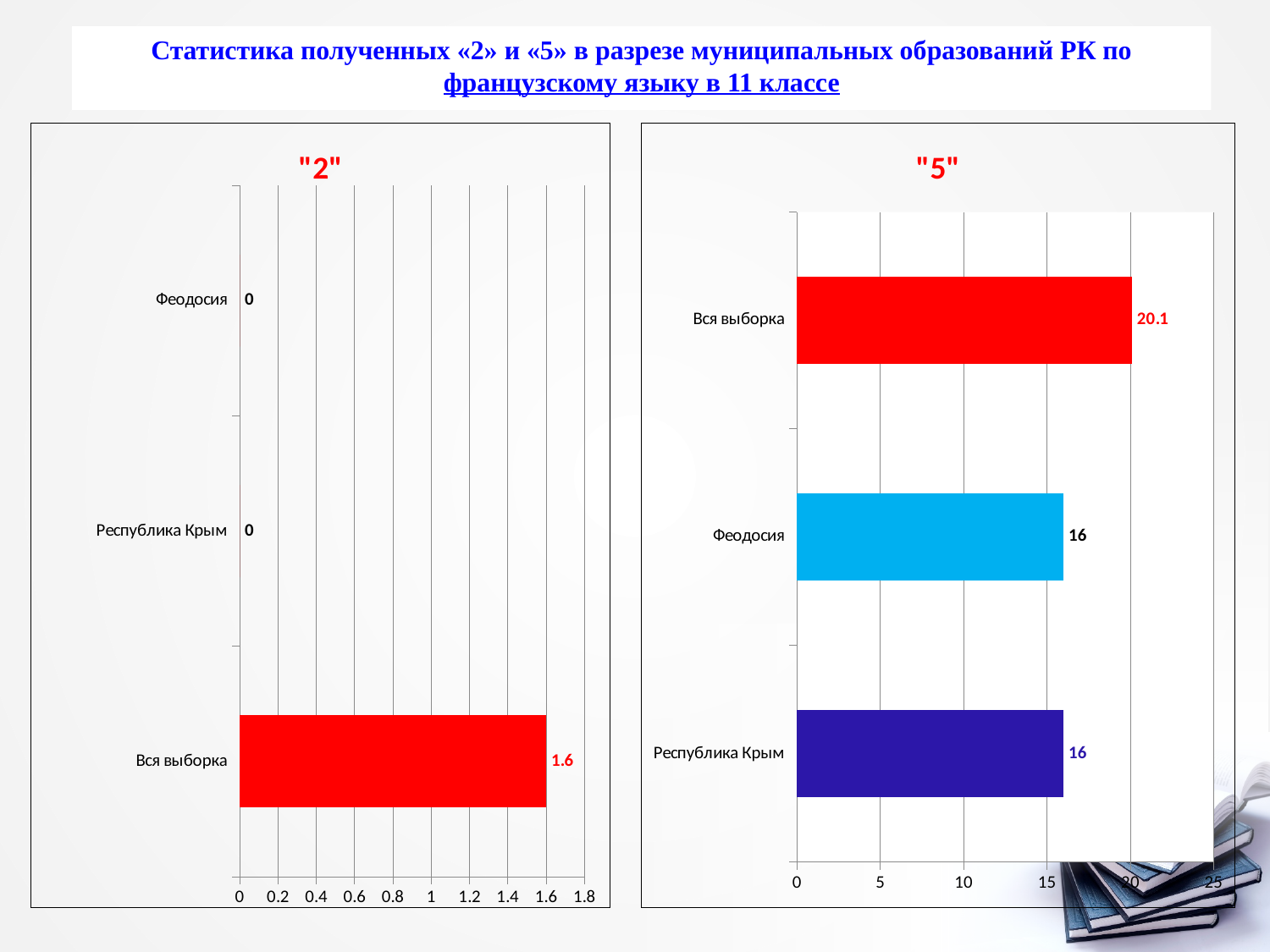
In the "5" chart, what is the difference between the values for Вся выборка and Феодосия? 4.1 In the "2" chart, what is the value for Вся выборка? 1.6 In the "5" chart, what is the value for Вся выборка? 20.1 In the "5" chart, which category has the highest value? Вся выборка In the "5" chart, is the value for Вся выборка greater or less than 20? greater In the "2" chart, what is the value for Феодосия? 0 In the "2" chart, how many categories are shown? 3 In the "5" chart, what is the value for Феодосия? 16 In the "2" chart, what is the difference between the values for Вся выборка and Республика Крым? 1.6 In the "5" chart, what is the value for Республика Крым? 16 What kind of chart is the "5" chart? bar chart In the "2" chart, which category has the highest value? Вся выборка